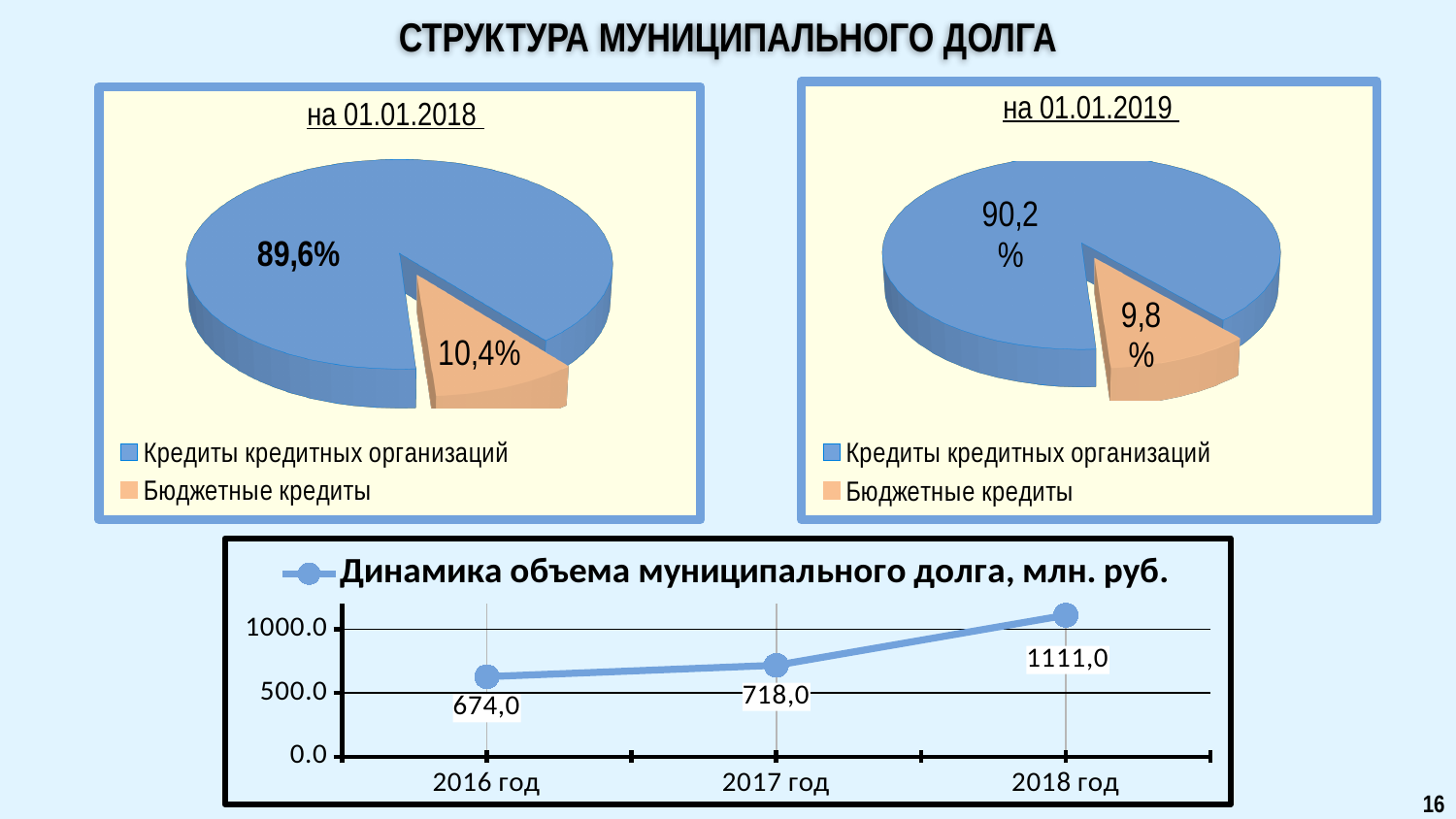
In the chart 'Динамика объема муниципального долга, млн. руб.', what is the value for 2018 год? 1111,0 In the pie chart 'на 01.01.2019', which category has the largest slice? Кредиты кредитных организаций In the chart 'Динамика объема муниципального долга, млн. руб.', how many data points are plotted? 3 In the pie chart 'на 01.01.2018', what share is shown for Бюджетные кредиты? 10,4% In the pie chart 'на 01.01.2019', what share is shown for Кредиты кредитных организаций? 90,2% In the chart 'Динамика объема муниципального долга, млн. руб.', what is the value for 2017 год? 718,0 In the pie chart 'на 01.01.2019', what share is shown for Бюджетные кредиты? 9,8% In the pie chart 'на 01.01.2018', how many slices does the pie have? 2 What kind of chart is the chart titled 'Динамика объема муниципального долга, млн. руб.'? line chart In the chart 'Динамика объема муниципального долга, млн. руб.', do the values rise or fall from 2016 год to 2018 год? rise In the pie chart 'на 01.01.2018', what share is shown for Кредиты кредитных организаций? 89,6% In the chart 'Динамика объема муниципального долга, млн. руб.', what is the difference between the values for 2018 год and 2016 год? 437,0